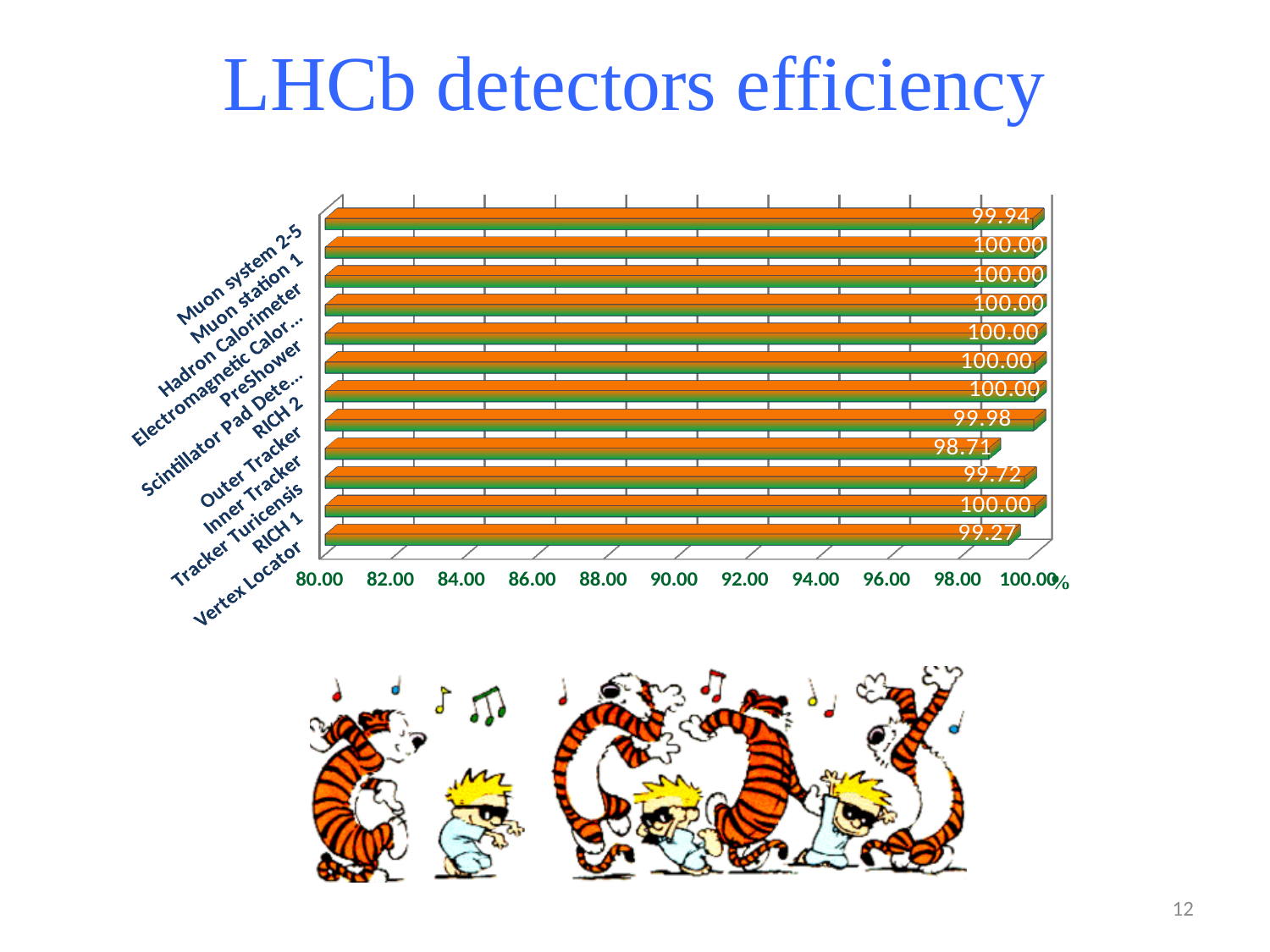
Is the efficiency value for the Inner Tracker greater or less than 98.00? greater Which detector has the lowest efficiency in the chart? Inner Tracker What kind of chart is used on this slide? bar chart What is the efficiency value shown for the Inner Tracker? 98.71 How many detectors (bars) are shown in the chart? 12 What is the efficiency value shown for the Outer Tracker? 99.98 What is the difference between the Outer Tracker and Inner Tracker efficiency values? 1.27 What is the efficiency value shown for the Vertex Locator? 99.27 What is the efficiency value shown for Tracker Turicensis? 99.72 What is the efficiency value shown for Muon system 2-5? 99.94 What is the title of the slide containing the chart? LHCb detectors efficiency Which has the higher efficiency, the Vertex Locator or Tracker Turicensis? Tracker Turicensis